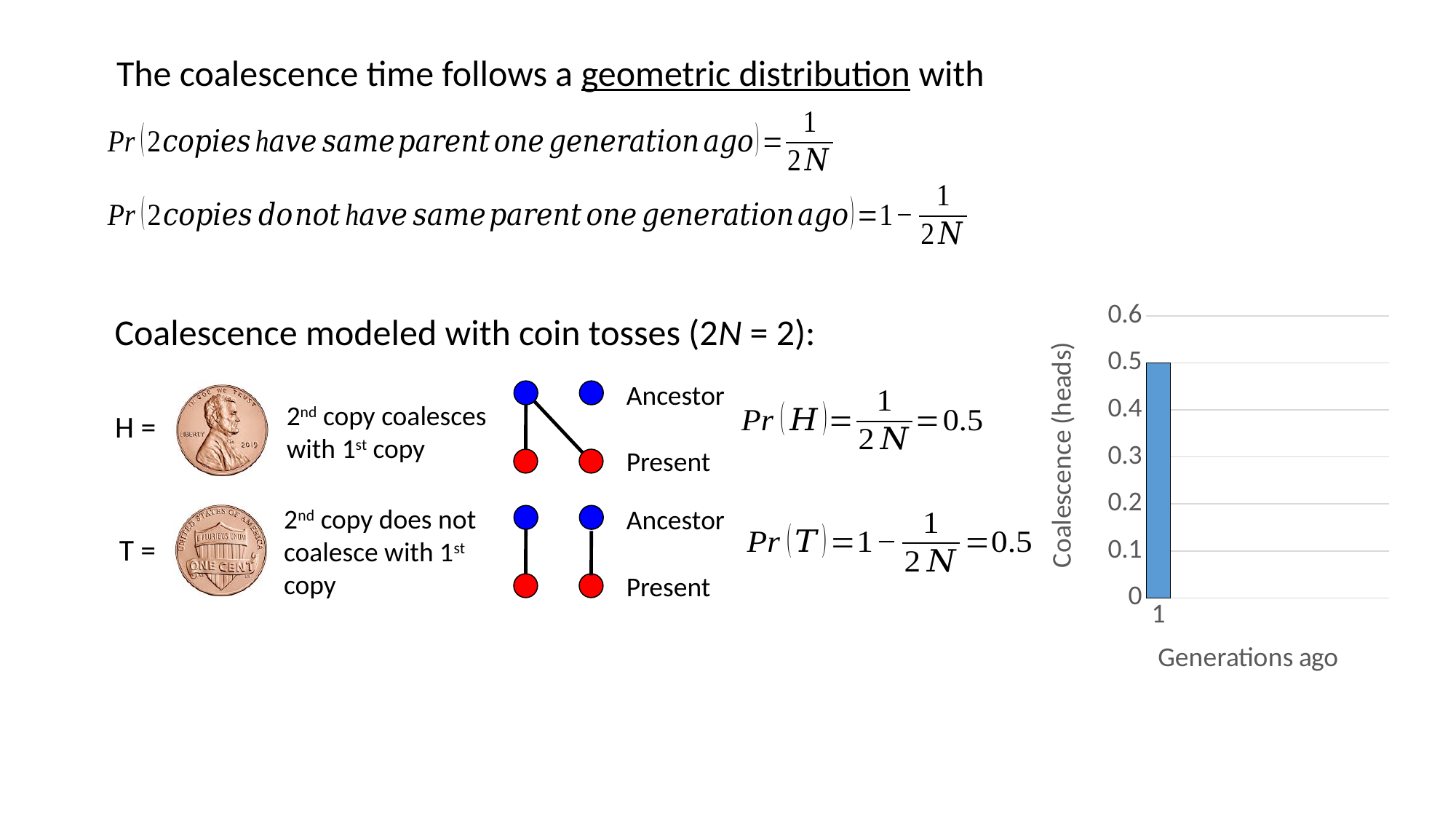
Is the value of the bar for 1 generation ago greater or less than 0.4? greater What kind of chart is shown on the right side of the slide? bar chart What is the highest tick value shown on the vertical axis of the chart? 0.6 Is the value of the bar for 1 generation ago greater or less than 0.6? less What category label appears under the single bar on the horizontal axis? 1 What is the label of the horizontal axis of the chart? Generations ago What is the value of the bar at 1 generation ago? 0.5 What is the label of the vertical axis of the chart? Coalescence (heads) How many bars are plotted in the chart? 1